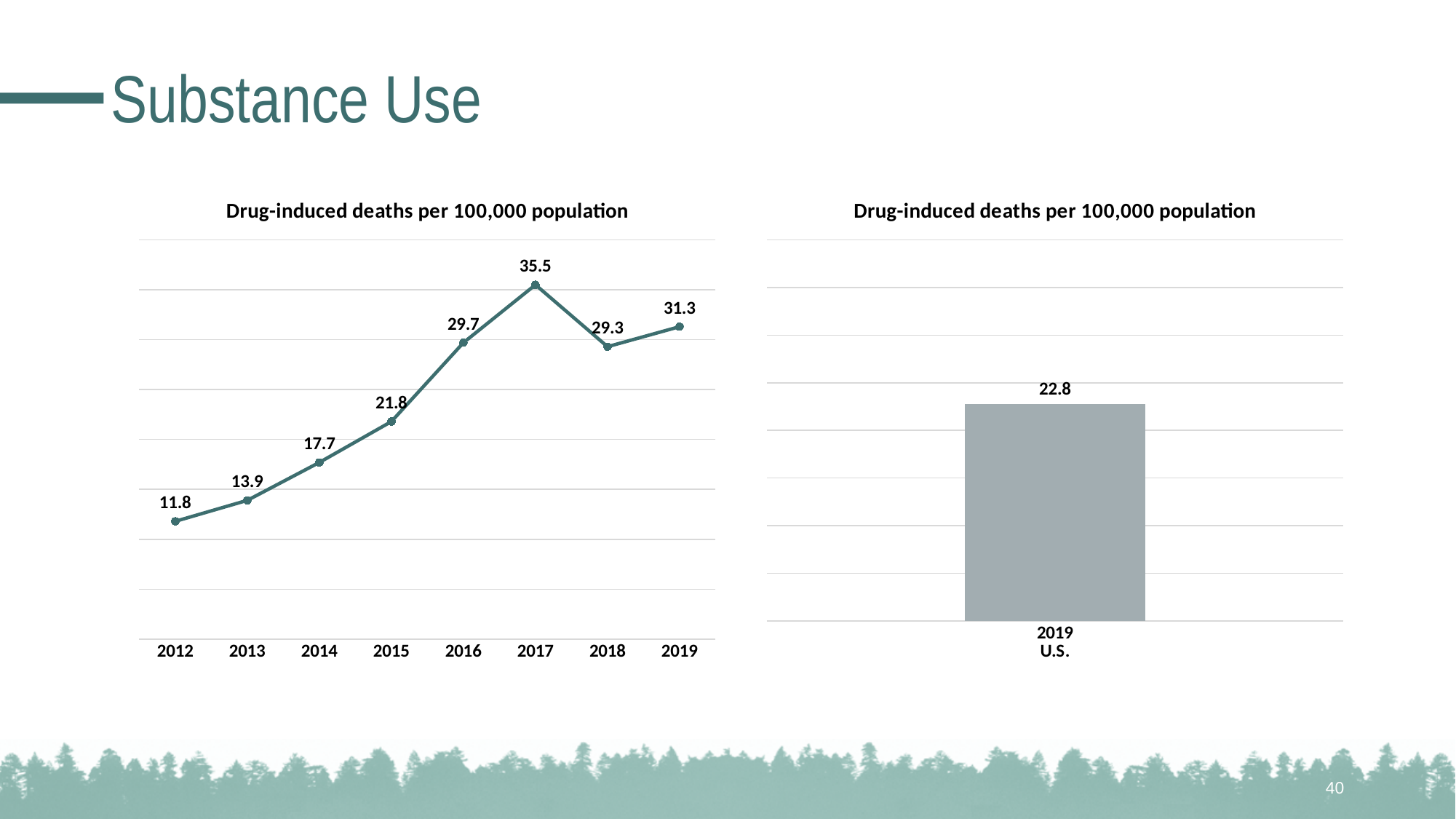
In the left chart, what is the value for 2012? 11.8 In the left chart, which is larger, the value for 2016 or the value for 2018? 2016 How many years are plotted in the left chart? 8 What kind of chart is the right chart? bar chart In the left chart, which year has the lowest value? 2012 In the left chart, what is the value for 2019? 31.3 What kind of chart is the left chart? line chart In the left chart, which year has the highest value? 2017 In the left chart, what is the difference between the 2017 and 2018 values? 6.2 In the left chart, do the values rise or fall from 2012 to 2017? rise In the right chart, what is the value for 2019 U.S.? 22.8 In the left chart, what is the value for 2017? 35.5